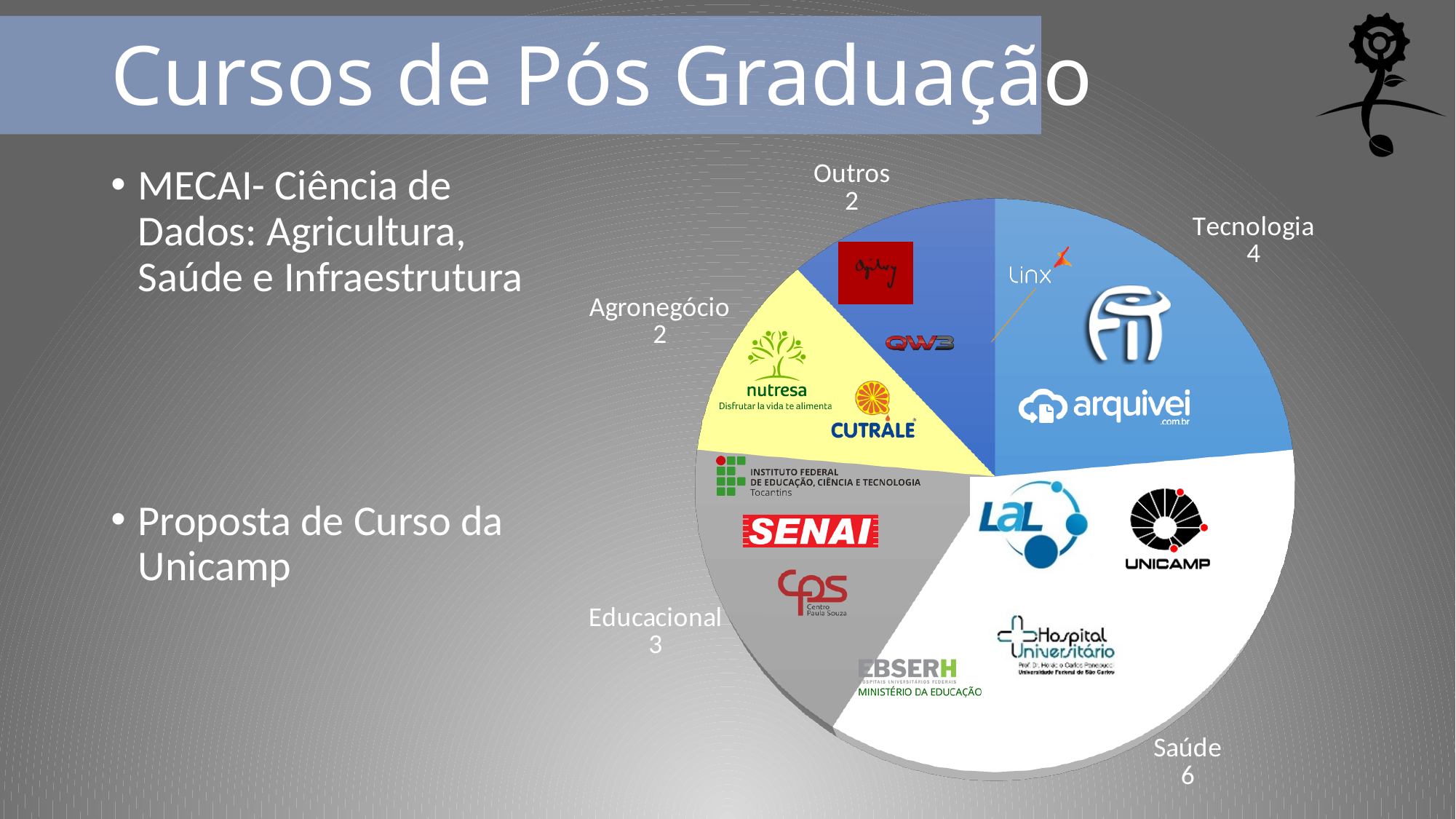
What kind of chart is shown on the slide? pie chart What is the value for Tecnologia in the pie chart? 4 Which category has the largest slice in the pie chart? Saúde Which is larger, the value for Tecnologia or the value for Educacional? Tecnologia What is the value for Educacional in the pie chart? 3 What colour is the Agronegócio slice of the pie chart? yellow What is the value for Saúde in the pie chart? 6 What is the value for Agronegócio in the pie chart? 2 What is the difference between the values for Saúde and Tecnologia? 2 What is the total of all the values shown in the pie chart? 17 How many categories does the pie chart have? 5 Which categories share the smallest value in the pie chart? Outros and Agronegócio